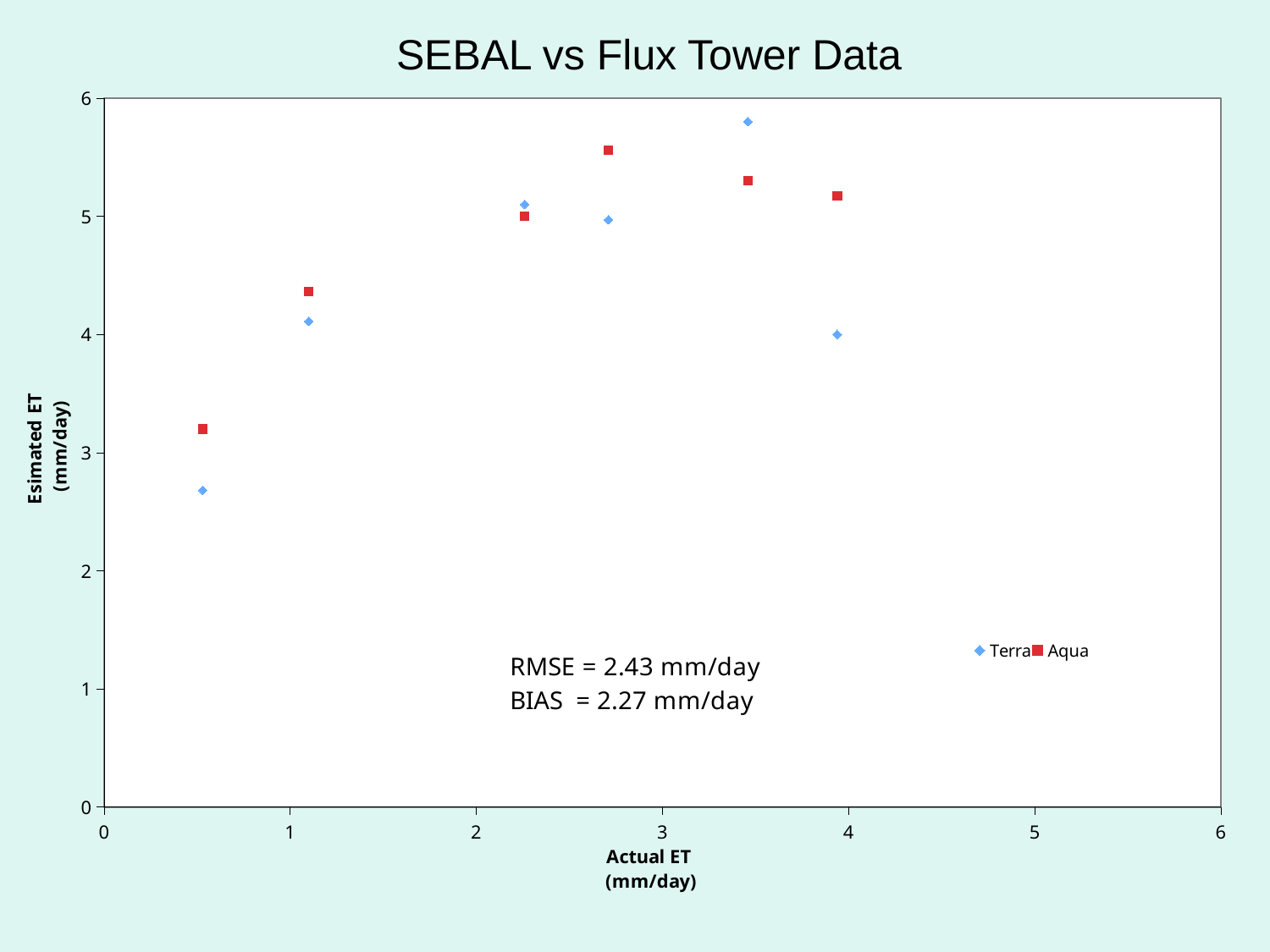
What BIAS value is stated on the chart? 2.27 mm/day How many Aqua points are plotted on the chart? 6 At the lowest Actual ET value, which series has the higher Estimated ET, Terra or Aqua? Aqua At the highest Actual ET value (near 4 mm/day), which series has the higher Estimated ET, Terra or Aqua? Aqua What RMSE value is stated on the chart? 2.43 mm/day How many Terra points are plotted on the chart? 6 What kind of chart is shown on the slide? Scatter chart Is the Estimated ET value for the Terra point with the lowest Actual ET greater or less than 3? less Is the Estimated ET value for the Aqua point with the lowest Actual ET greater or less than 3? greater Is the Estimated ET value for the highest Terra point greater or less than 5? greater Which series contains the single highest Estimated ET point on the chart? Terra How many series does the legend list? 2